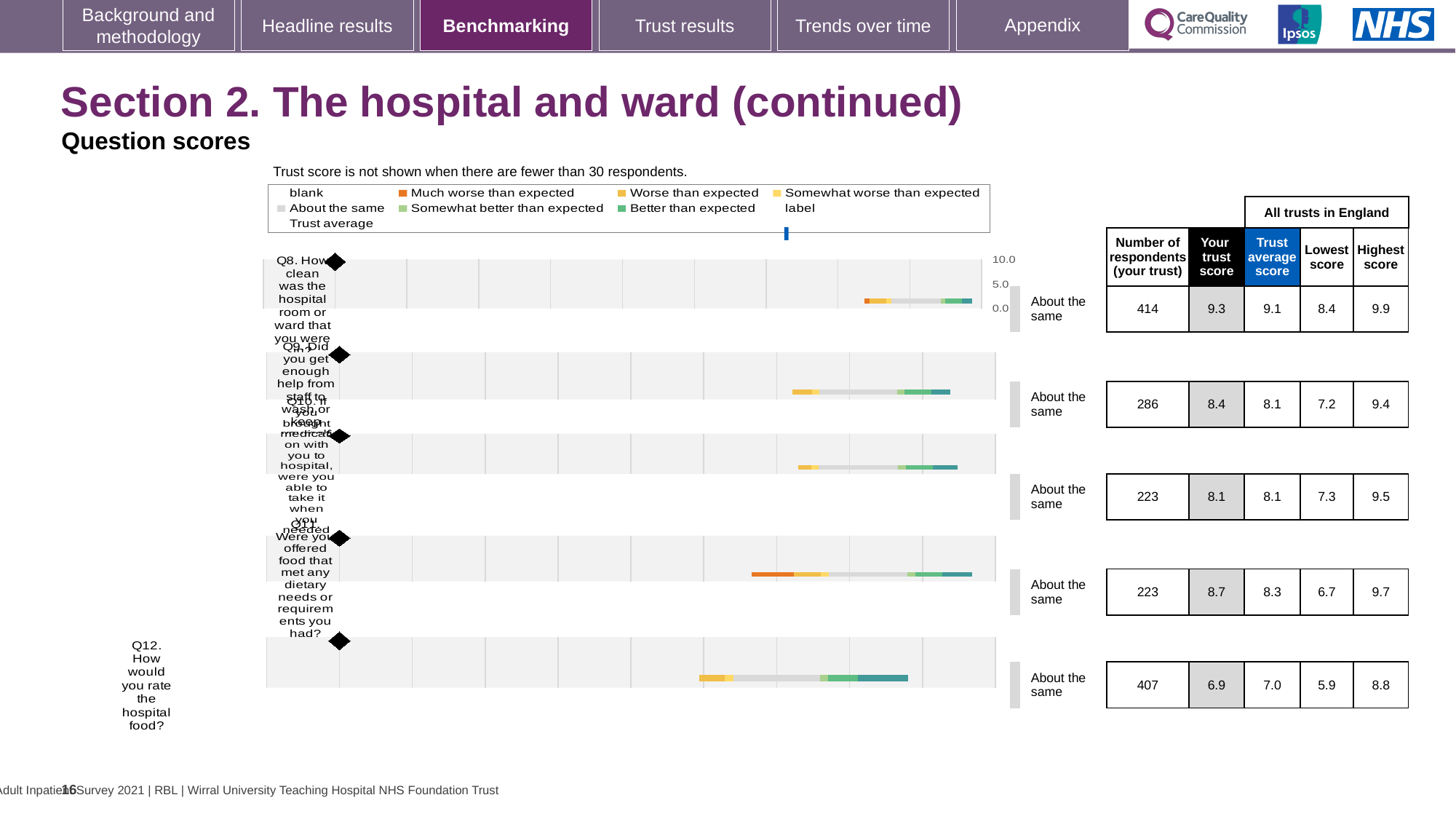
For Q11, which is larger: your trust score or the trust average score? Your trust score What is the lowest score across all trusts in England for Q9 (Did you get enough help from staff to wash or keep yourself clean)? 7.2 Which question has the lowest 'Your trust score'? Q12 How many respondents from your trust answered Q12 (How would you rate the hospital food)? 407 What is the 'Your trust score' value for Q8 (How clean was the hospital room or ward)? 9.3 What kind of chart is used to show the question scores on this slide? bar chart What is the difference between the trust score and the trust average score for Q8? 0.2 What benchmark category is shown for Q12 (How would you rate the hospital food)? About the same How many questions (Q8 to Q12) are plotted in the question scores chart? 5 What is the highest score across all trusts in England for Q11 (Were you offered food that met any dietary needs or requirements you had)? 9.7 Which question has the highest 'Your trust score'? Q8 What is the subtitle of the chart on this slide? Question scores